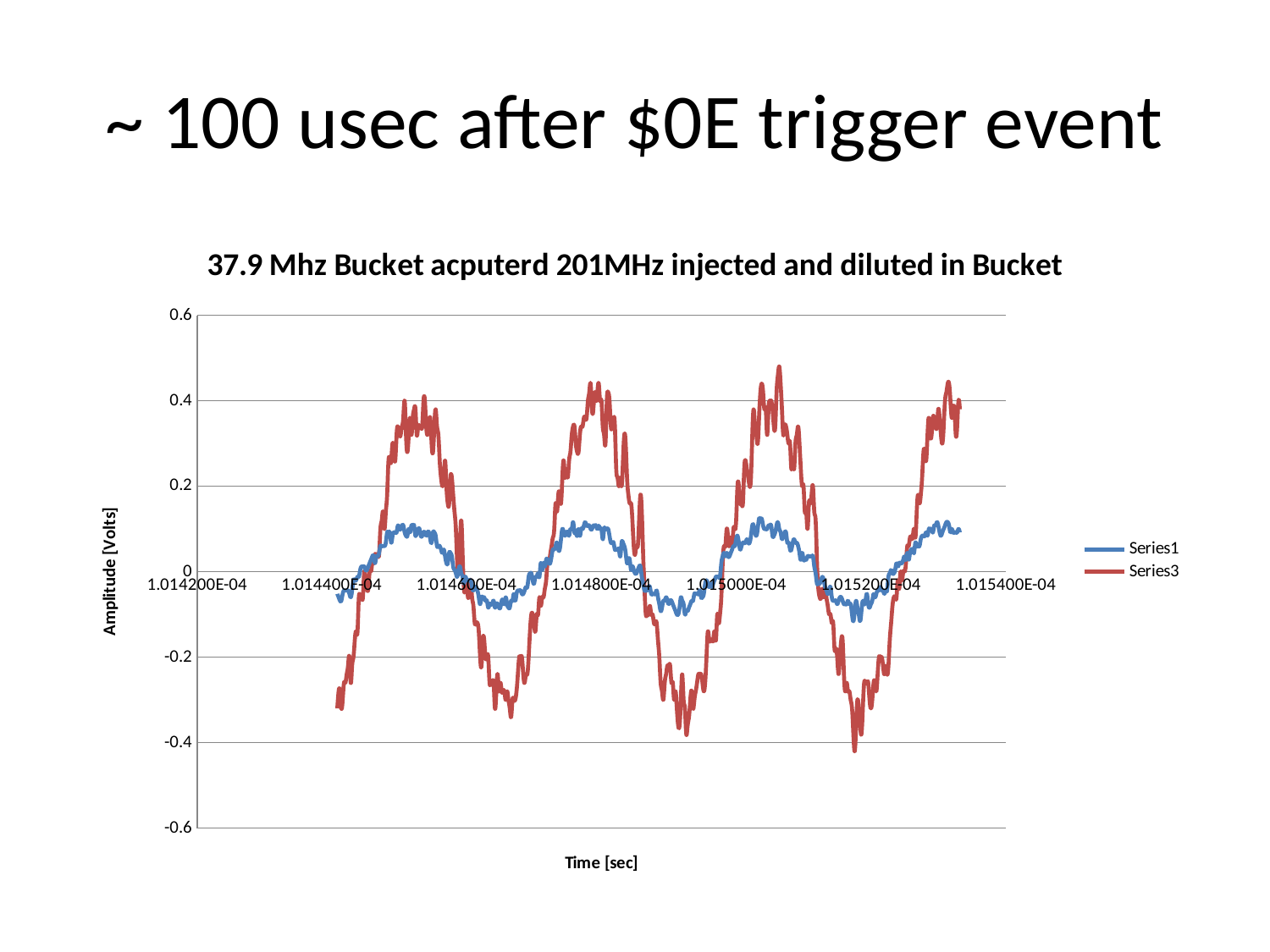
What is the title of the chart? 37.9 Mhz Bucket acputerd 201MHz injected and diluted in Bucket Which series reaches the highest value on the chart? Series3 How many series does the legend list? 2 What is the label of the vertical axis? Amplitude [Volts] Is the lowest trough of Series3 greater or less than -0.2? less Is the lowest trough of Series1 greater or less than -0.2? greater What kind of chart is shown on the slide? line chart Which series reaches the lowest value on the chart? Series3 Which series has the larger peak amplitude, Series1 or Series3? Series3 Is the highest peak of Series1 greater or less than 0.2? less Do the values of Series3 rise steadily, fall steadily, or oscillate along the x axis? oscillate